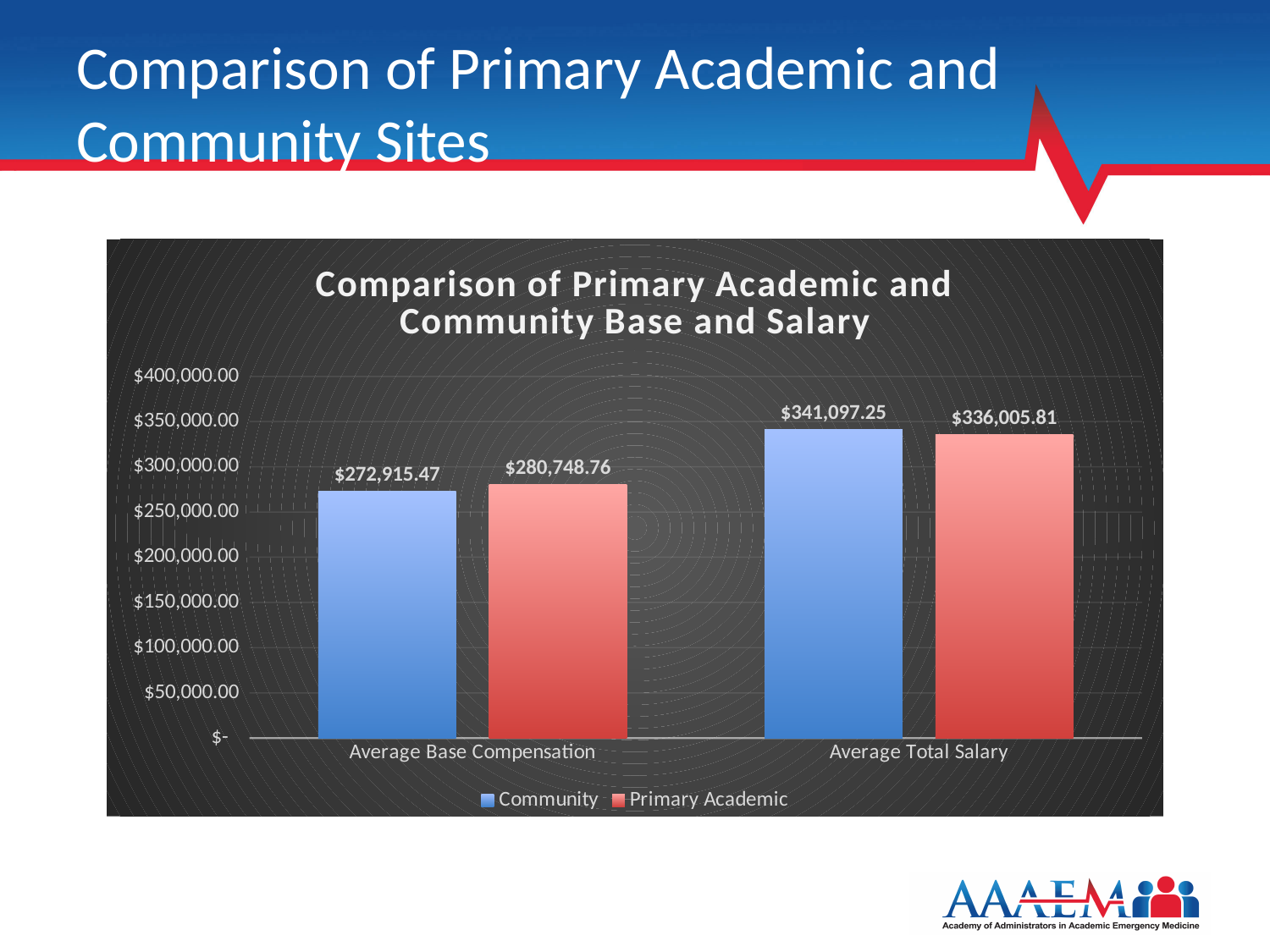
What is the difference between the Community and Primary Academic values for Average Total Salary? $5,091.44 What is the Primary Academic value for Average Total Salary? $336,005.81 What is the Community value for Average Total Salary? $341,097.25 What kind of chart is shown on the slide? Bar chart What is the title of the chart? Comparison of Primary Academic and Community Base and Salary What is the Community value for Average Base Compensation? $272,915.47 What is the difference between the Primary Academic and Community values for Average Base Compensation? $7,833.29 How many categories are shown on the x axis? 2 Which series has the higher value for Average Total Salary, Community or Primary Academic? Community Which series has the higher value for Average Base Compensation, Community or Primary Academic? Primary Academic What is the Primary Academic value for Average Base Compensation? $280,748.76 How many series does the legend list? 2